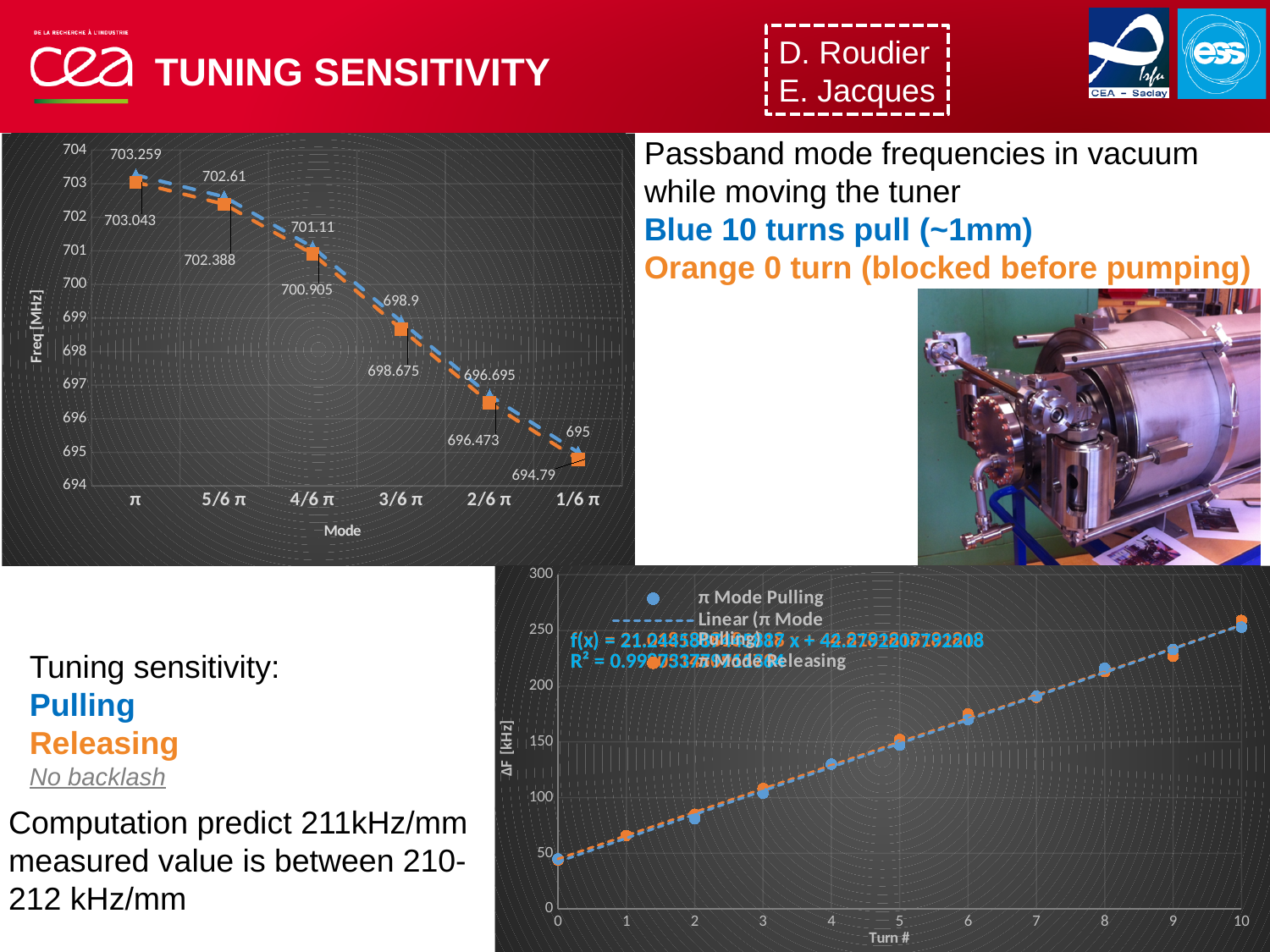
What is the y-axis label of the top-left chart? Freq [MHz] In the top-left chart, which is larger at mode 2/6 π: the blue value or the orange value? blue (696.695) In the bottom-right chart, is the ΔF value at turn 0 greater or less than 50? less In the top-left chart, how many modes are shown on the x axis? 6 In the top-left chart, what is the difference between the blue and orange values at mode 3/6 π? 0.225 In the bottom-right chart, does ΔF rise or fall as Turn # increases? rise In the bottom-right chart, is the ΔF value at turn 8 greater or less than 200? greater In the top-left chart, what is the blue series value at mode π? 703.259 In the top-left chart, what is the orange series value at mode 4/6 π? 700.905 In the top-left chart, do the frequencies rise or fall from π to 1/6 π? fall In the top-left chart, which mode has the lowest blue series value? 1/6 π In the top-left chart, what is the orange series value at mode 1/6 π? 694.79